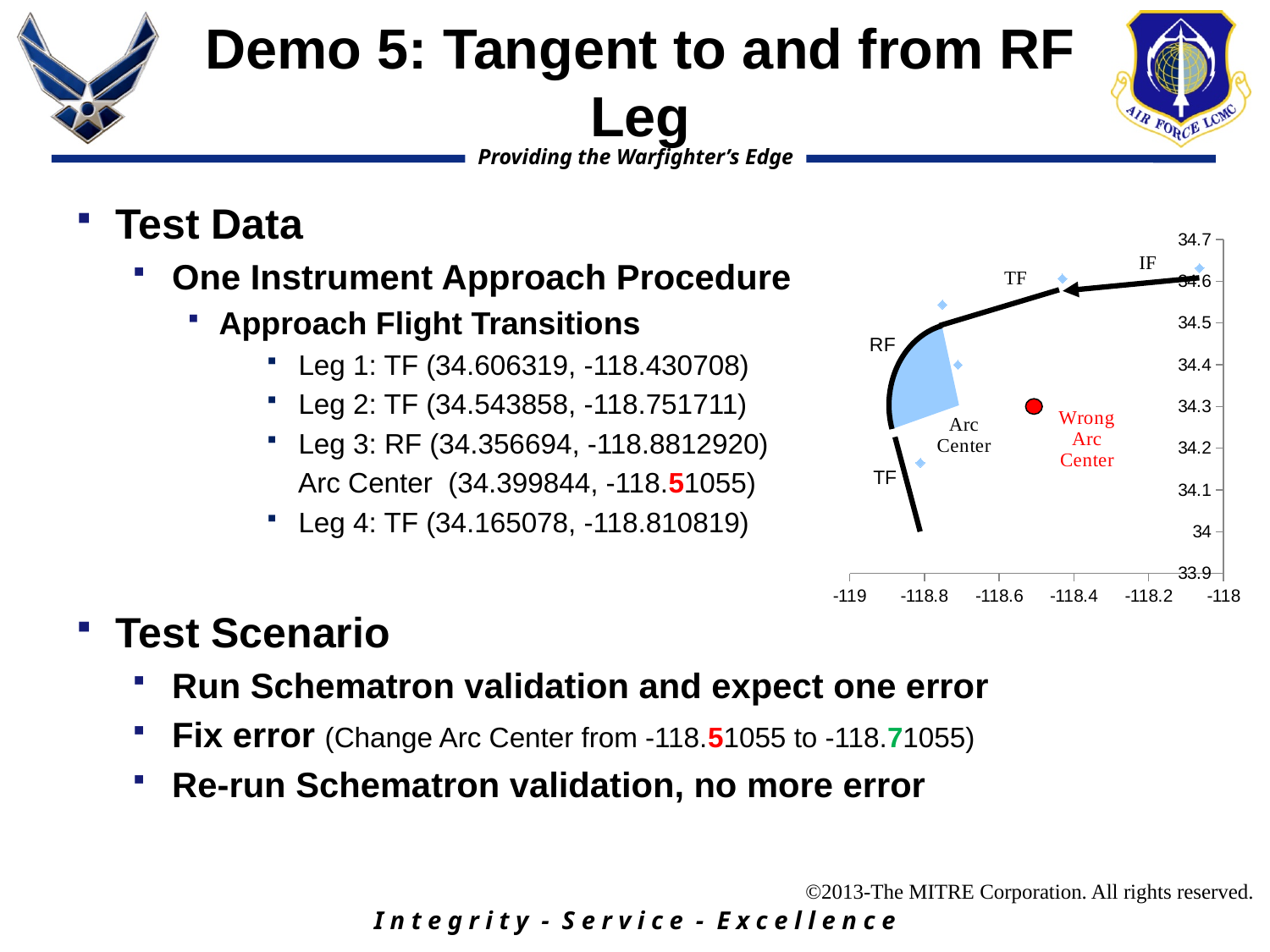
Which labelled point on the chart has the highest vertical-axis value? IF Is the vertical-axis value of the point labelled Wrong Arc Center greater or less than 34.5? less What kind of chart is shown on the slide? scatter chart Is the vertical-axis value of the point labelled IF greater or less than 34.5? greater Is the vertical-axis value of the lower point labelled TF greater or less than 34.3? less What is the leftmost value shown on the horizontal axis of the chart? -119 Which labelled point on the chart has the lowest vertical-axis value? the lower TF Which has the greater vertical-axis value, the point labelled IF or the point labelled Wrong Arc Center? IF Moving from left to right along the horizontal axis, does the plotted flight path generally rise or fall? rise What is the highest value shown on the vertical axis of the chart? 34.7